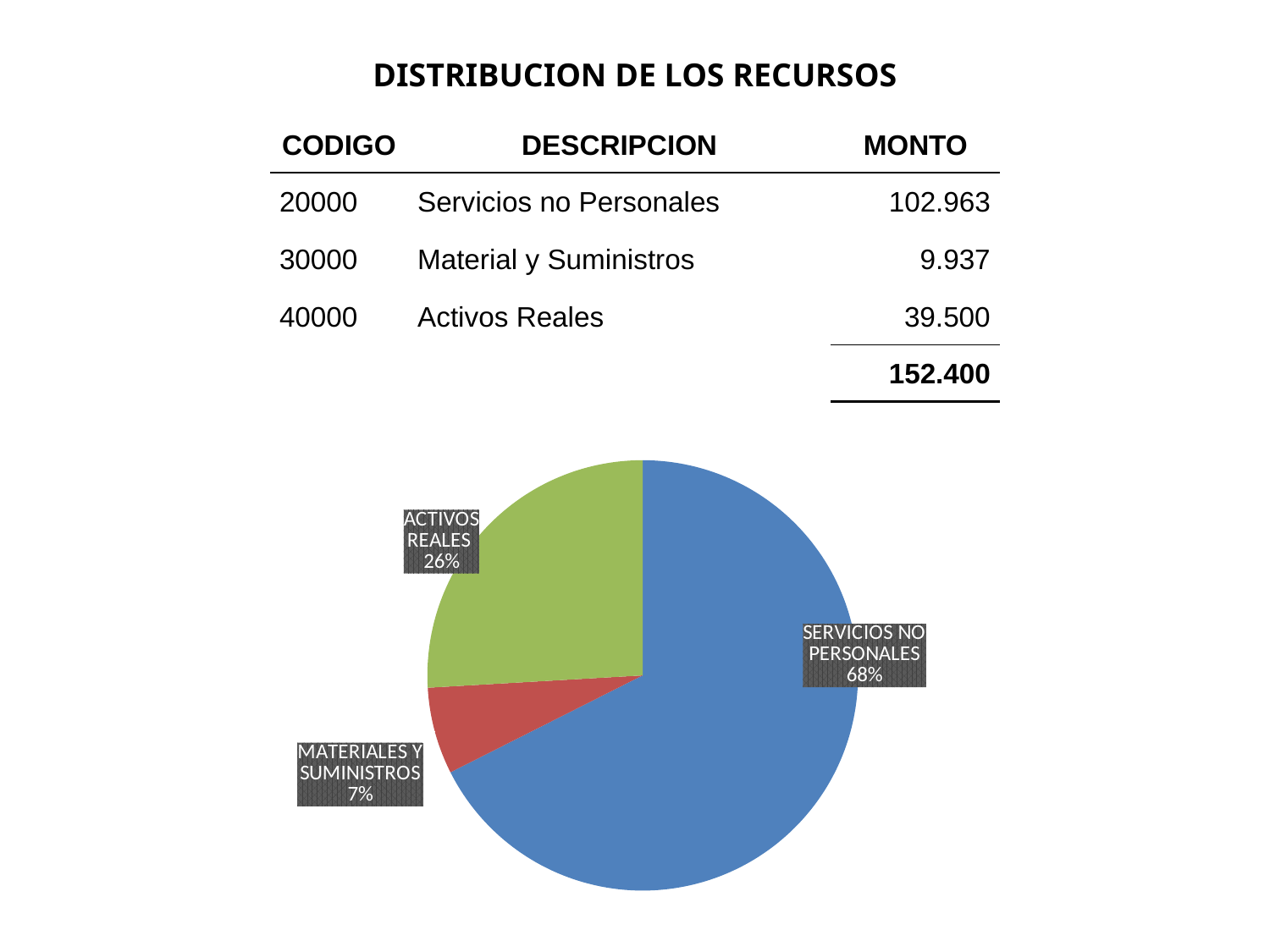
What is the difference in percentage points between the Servicios no Personales slice and the Activos Reales slice? 42 What share of the pie does the Activos Reales slice represent? 26% What colour is the Activos Reales slice in the pie chart? Green How many slices does the pie chart have? 3 What is the difference in percentage points between the Activos Reales slice and the Materiales y Suministros slice? 19 What kind of chart is shown on the slide? Pie chart Which slice of the pie chart is the largest? Servicios no Personales Which slice of the pie chart is the smallest? Materiales y Suministros What colour is the Servicios no Personales slice in the pie chart? Blue Which slice is larger, Activos Reales or Materiales y Suministros? Activos Reales What share of the pie does the Servicios no Personales slice represent? 68% What share of the pie does the Materiales y Suministros slice represent? 7%